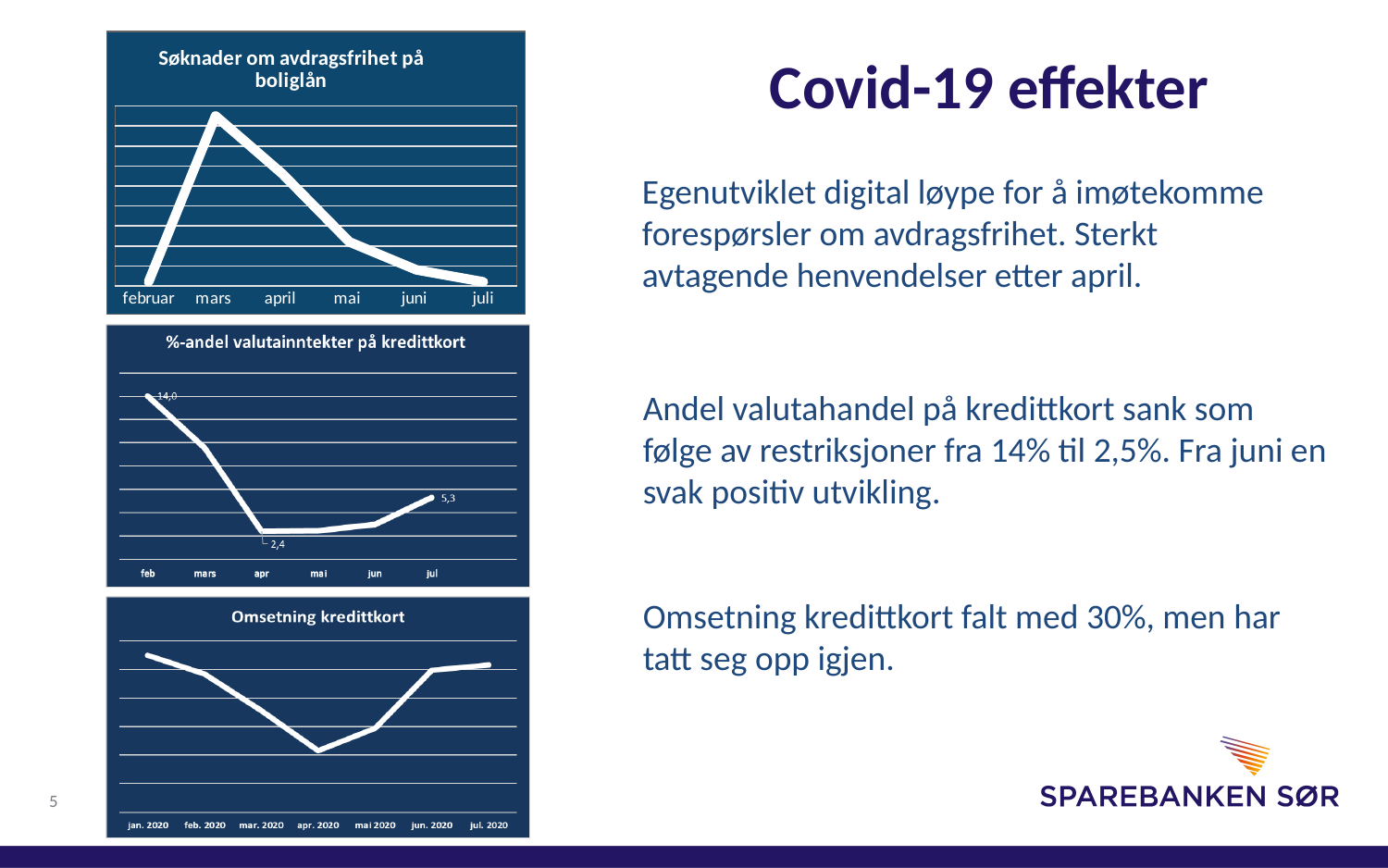
In the chart titled "%-andel valutainntekter på kredittkort", which month has the highest value? feb What kind of chart is the chart titled "Omsetning kredittkort"? line chart In the chart titled "Omsetning kredittkort", how many months are plotted on the x axis? 7 In the chart titled "Omsetning kredittkort", which month has the lowest value? apr. 2020 In the chart titled "%-andel valutainntekter på kredittkort", what is the value for jul? 5,3 In the chart titled "%-andel valutainntekter på kredittkort", what is the difference between the feb value and the apr value? 11,6 In the chart titled "%-andel valutainntekter på kredittkort", how many months are plotted on the x axis? 6 In the chart titled "%-andel valutainntekter på kredittkort", what is the value for apr? 2,4 In the chart titled "Søknader om avdragsfrihet på boliglån", which month has the highest value? mars In the chart titled "%-andel valutainntekter på kredittkort", what is the value for feb? 14,0 In the chart titled "Søknader om avdragsfrihet på boliglån", do the values rise or fall from mars to juli? fall In the chart titled "%-andel valutainntekter på kredittkort", which month has the lowest value? apr